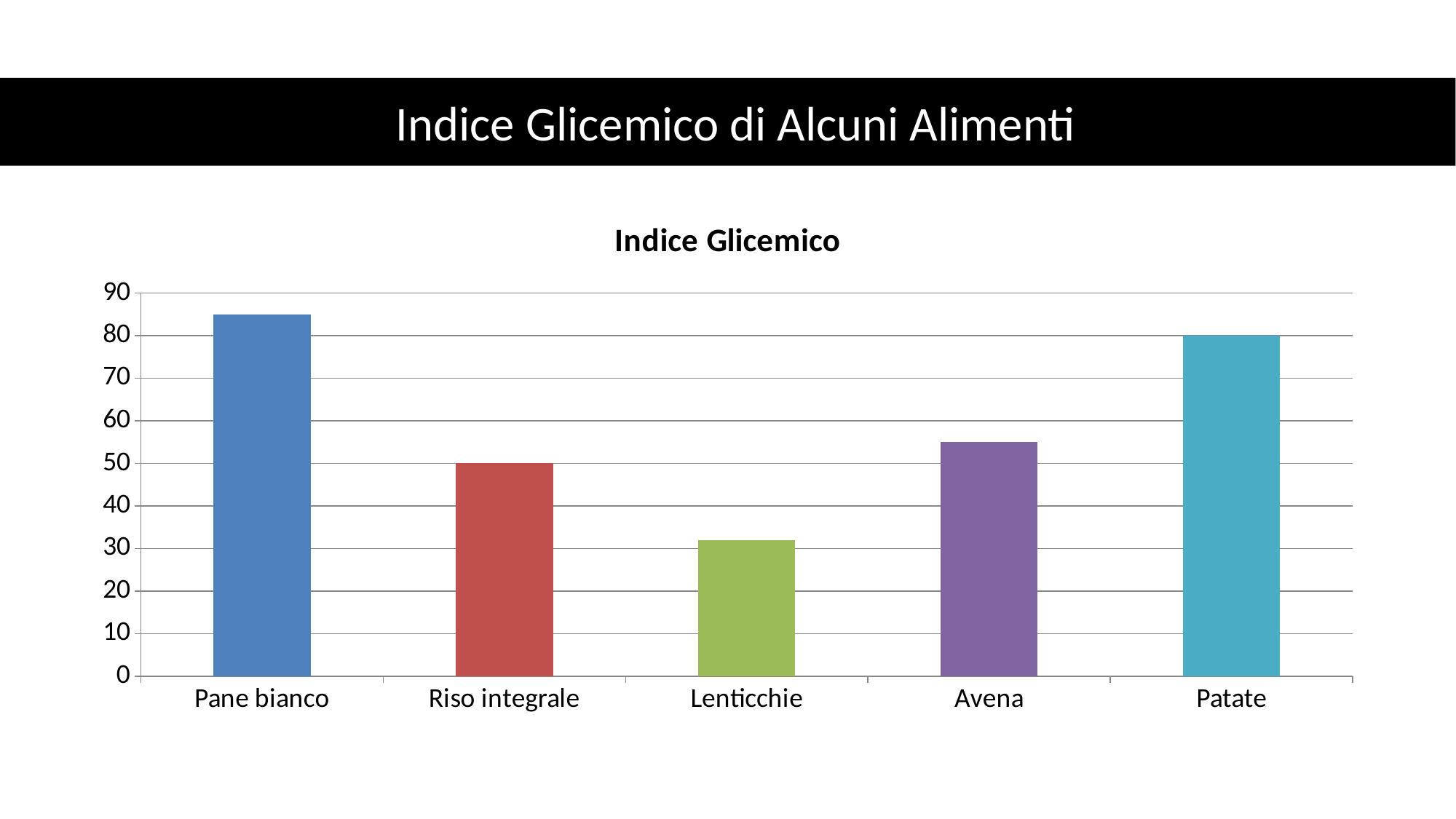
What is the value for Riso integrale? 50 How many food categories are shown on the x axis? 5 What is the difference between the values for Patate and Riso integrale? 30 Is the value for Pane bianco greater or less than 80? greater Which food has the highest glycemic index in the chart? Pane bianco What is the title of the chart? Indice Glicemico What is the value for Patate? 80 Which has a larger value, Avena or Riso integrale? Avena What kind of chart is shown on the slide? bar chart Is the value for Lenticchie greater or less than 40? less Is the value for Avena greater or less than 50? greater Which food has the lowest glycemic index in the chart? Lenticchie